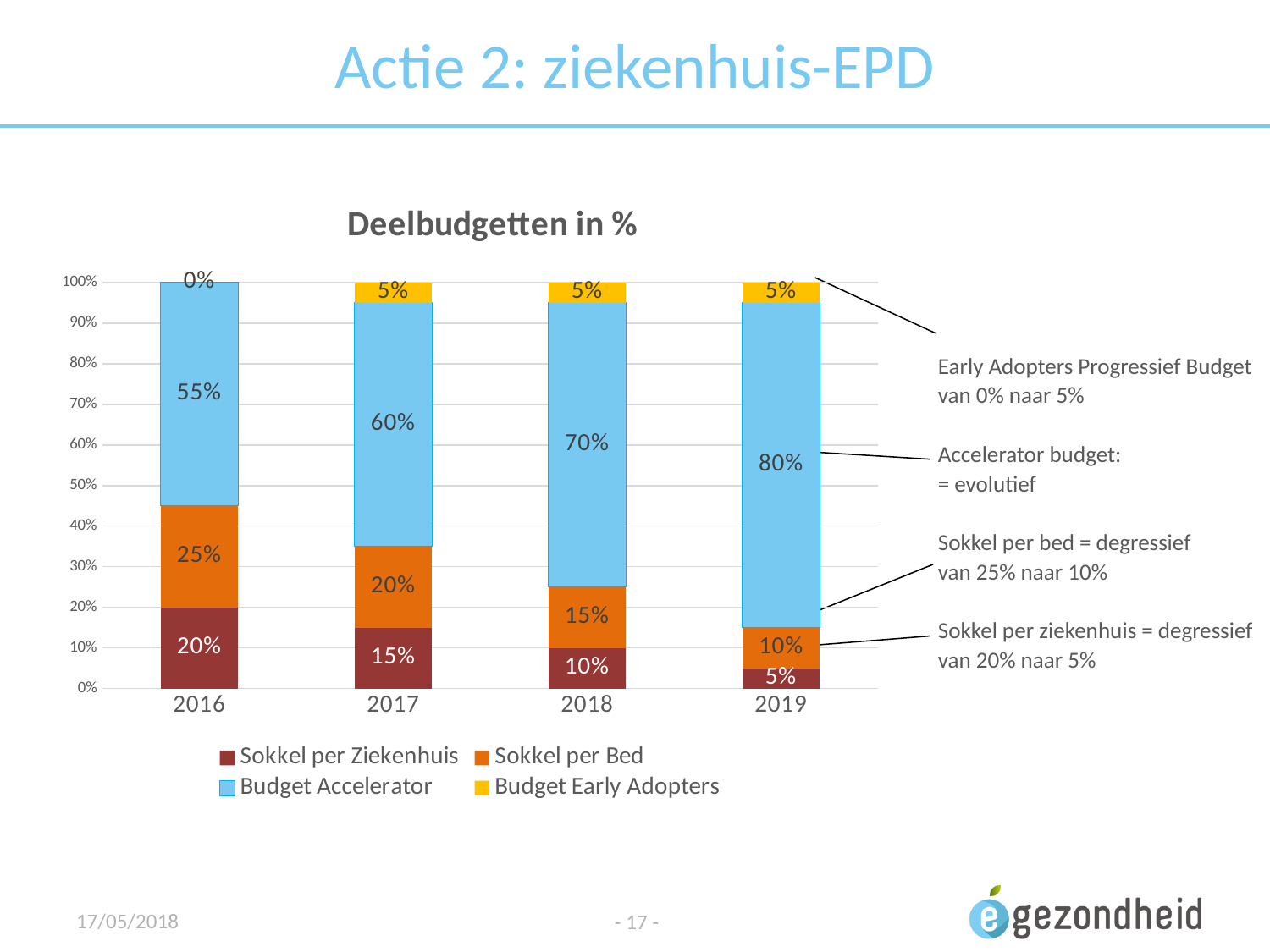
In which year is Budget Accelerator highest? 2019 What is the value of Sokkel per Bed for 2019? 10% What type of chart is shown? stacked bar chart Does Budget Accelerator rise or fall from 2016 to 2019? rise How many years are shown on the x axis? 4 What is the value of Budget Accelerator for 2018? 70% What is the value of Budget Early Adopters for 2016? 0% In which year is Sokkel per Ziekenhuis lowest? 2019 How many series does the legend list? 4 Which is larger: Sokkel per Bed in 2017 or Sokkel per Bed in 2018? Sokkel per Bed in 2017 What is the difference between Budget Accelerator in 2019 and in 2016? 25% What is the value of Sokkel per Ziekenhuis for 2016? 20%